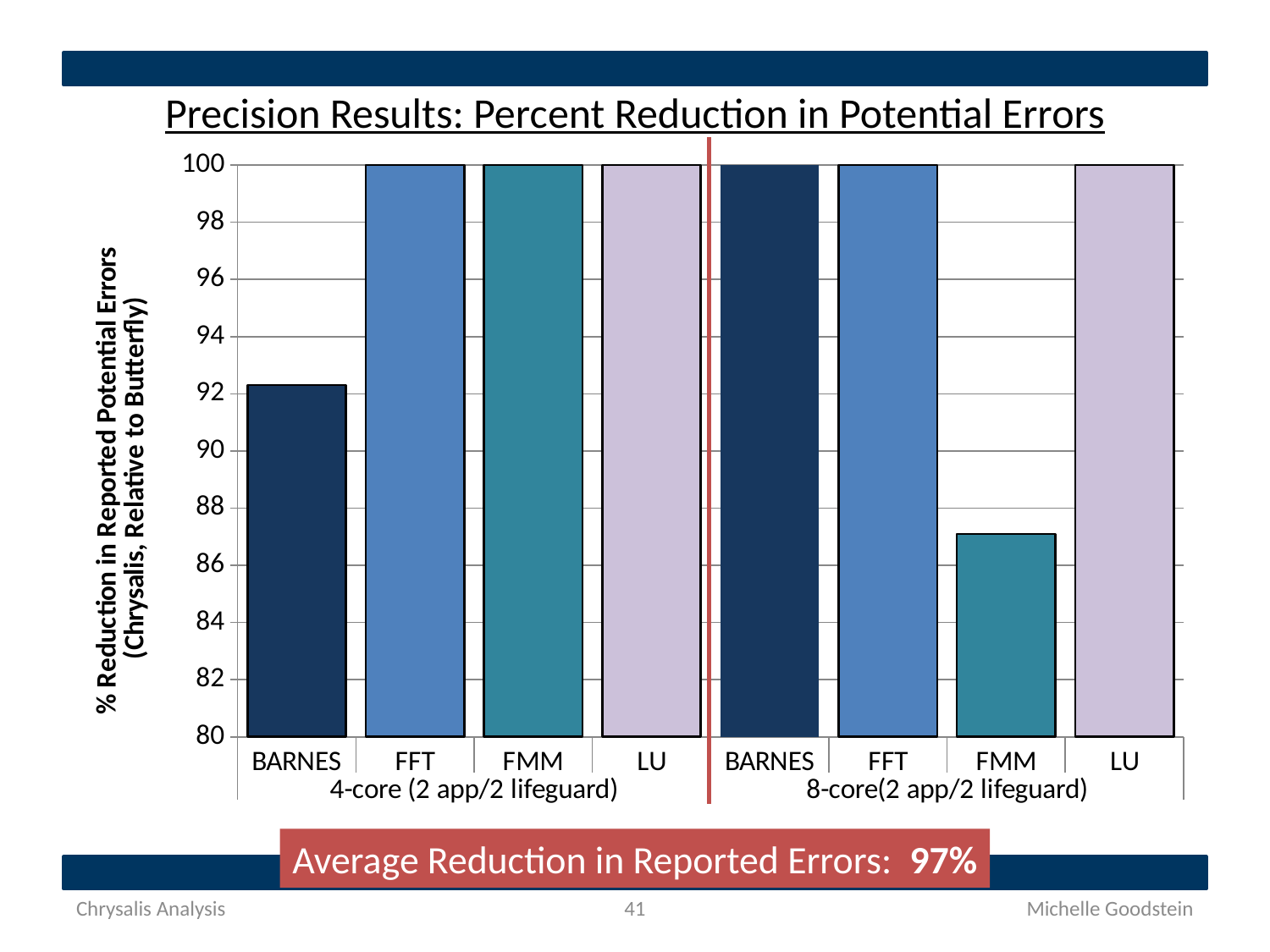
Which bar has the lowest value in the chart? FMM in the 8-core group How many core configuration groups does the x axis show? 2 What is the value for LU in the 8-core (2 app/2 lifeguard) group? 100 What is the title of the chart? Precision Results: Percent Reduction in Potential Errors How many bars are plotted in the chart? 8 What is the value for FFT in the 4-core (2 app/2 lifeguard) group? 100 What average reduction in reported errors is stated below the chart? 97% Is the value for FMM in the 8-core group greater or less than 88? less Is the value for BARNES in the 4-core group greater or less than 90? greater What is the value for BARNES in the 8-core (2 app/2 lifeguard) group? 100 Which is larger: BARNES in the 4-core group or FMM in the 8-core group? BARNES in the 4-core group What kind of chart is shown on the slide? bar chart